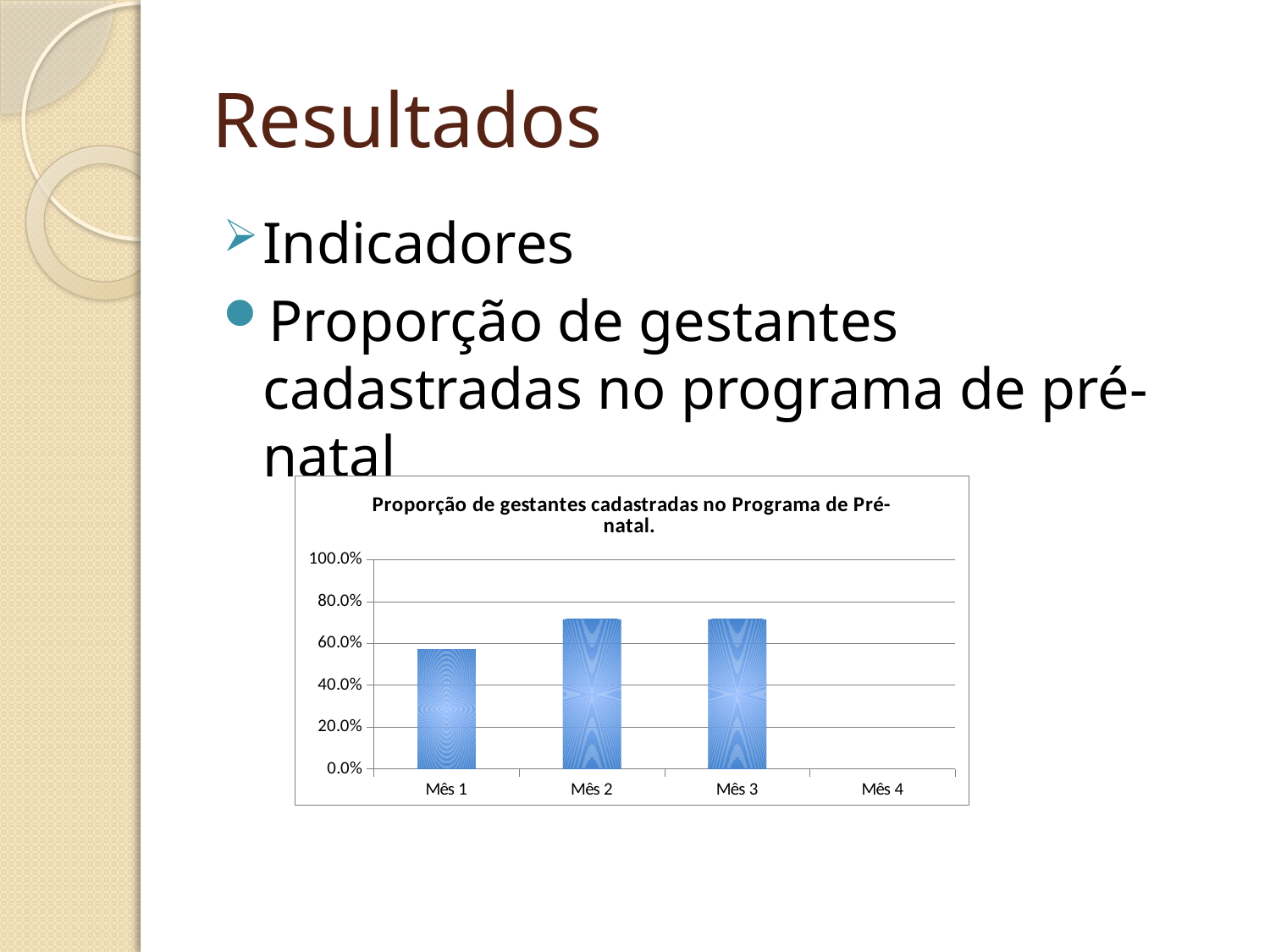
What is the highest value shown on the y axis of the chart? 100.0% How many categories are shown on the x axis of the chart? 4 Does the value rise or fall from Mês 1 to Mês 2? rise Is the value for Mês 3 greater or less than 80.0%? less Is the value for Mês 1 greater or less than 40.0%? greater What kind of chart is shown on the slide? bar chart Is the value for Mês 2 greater or less than 60.0%? greater Which is larger, the value for Mês 1 or the value for Mês 2? Mês 2 Which is larger, the value for Mês 1 or the value for Mês 3? Mês 3 What is the title of the chart? Proporção de gestantes cadastradas no Programa de Pré-natal.